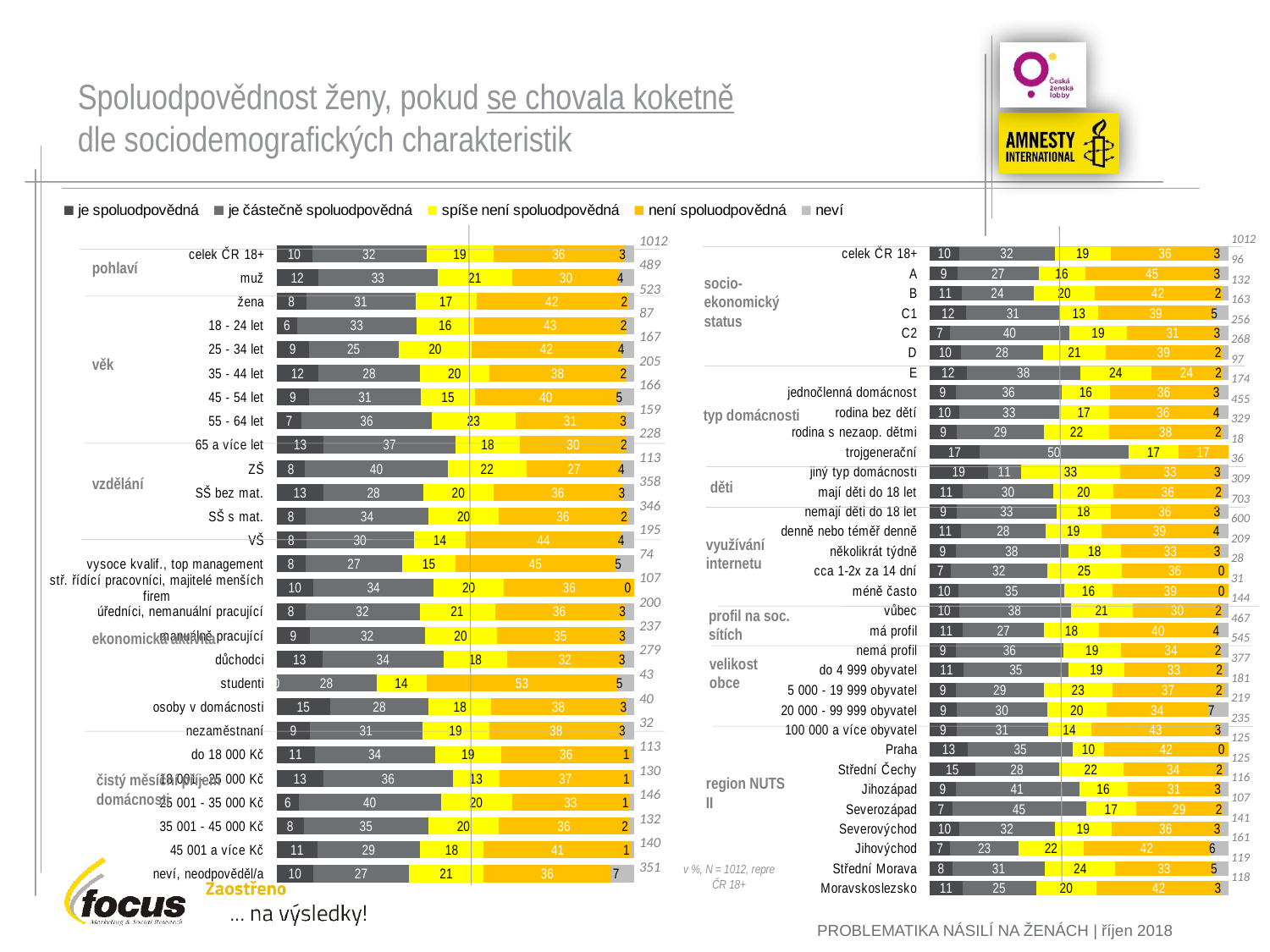
In the left chart, what is the value of 'není spoluodpovědná' for 'žena'? 42 How many series does the legend list? 5 In the left chart, what is the total of the stacked bar for 'celek ČR 18+'? 100 What kind of chart is shown on the left side of the slide? bar chart In the left chart, what is the difference between the 'není spoluodpovědná' values for 'žena' and 'muž'? 12 In the left chart, which category has the highest value for 'není spoluodpovědná'? studenti In the left chart, what is the value of 'je spoluodpovědná' for 'muž'? 12 In the right chart, what is the value of 'je spoluodpovědná' for 'Střední Čechy'? 15 In the right chart, what is the value of 'není spoluodpovědná' for 'Praha'? 42 In the left chart, what is the value of 'spíše není spoluodpovědná' for '55 - 64 let'? 23 In the right chart, what is the value of 'je částečně spoluodpovědná' for 'Severozápad'? 45 In the left chart, which has a larger 'není spoluodpovědná' value: '18 - 24 let' or '65 a více let'? 18 - 24 let